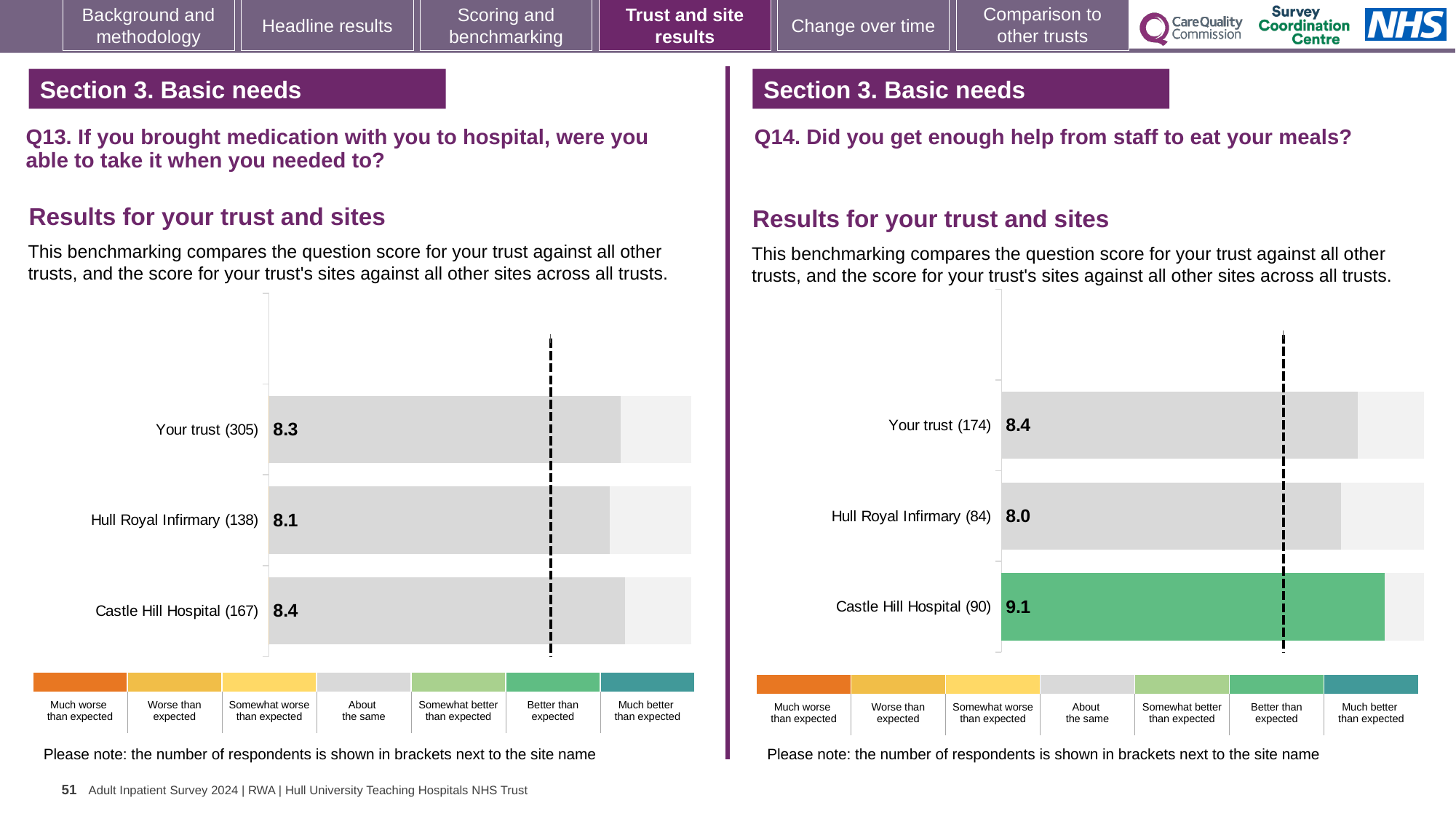
On the Q13 chart (left), what is the score for Hull Royal Infirmary? 8.1 On the Q14 chart (right), what is the score for Your trust? 8.4 On the Q14 chart (right), which has the larger score, Hull Royal Infirmary or Castle Hill Hospital? Castle Hill Hospital On the Q14 chart (right), what is the difference between the scores for Castle Hill Hospital and Your trust? 0.7 On the Q14 chart (right), what is the score for Castle Hill Hospital? 9.1 On the Q13 chart (left), what is the score for Your trust? 8.3 On the Q14 chart (right), which site or trust has the lowest score? Hull Royal Infirmary On the Q13 chart (left), how many bars are plotted? 3 On the Q13 chart (left), what is the difference between the scores for Castle Hill Hospital and Hull Royal Infirmary? 0.3 On the Q14 chart (right), how many respondents are shown in brackets for Castle Hill Hospital? 90 On the Q13 chart (left), which site or trust has the highest score? Castle Hill Hospital What kind of chart is used on the Q14 chart (right)? Bar chart